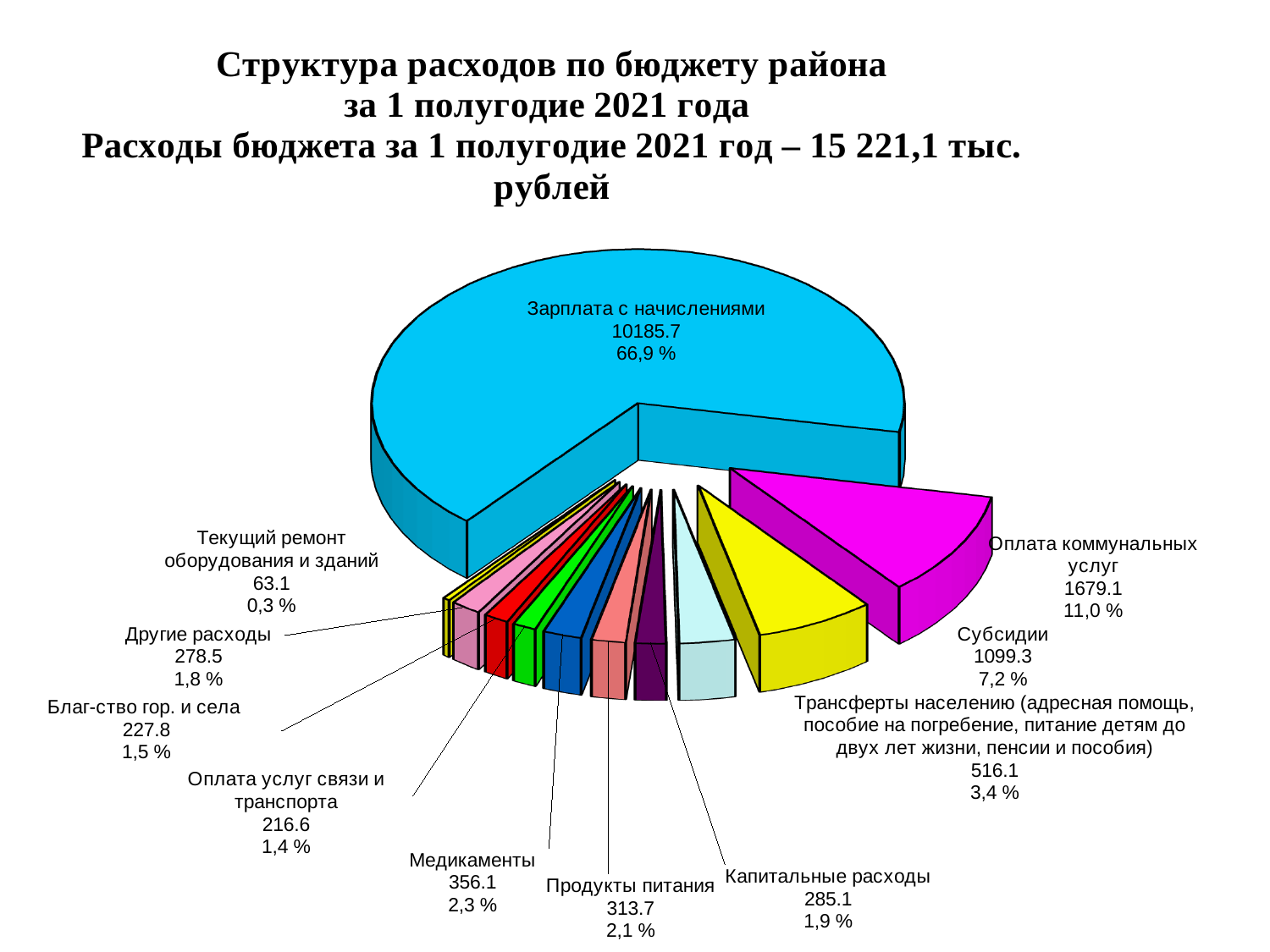
Which category has the smallest slice of the pie? Текущий ремонт оборудования и зданий What is the difference between the values for Оплата коммунальных услуг and Субсидии? 579.8 What is the value for Субсидии? 1099.3 Which category has the largest slice of the pie? Зарплата с начислениями What share of the pie does Оплата коммунальных услуг represent? 11,0 % What share of the pie does Текущий ремонт оборудования и зданий represent? 0,3 % Which is larger, the value for Медикаменты or the value for Продукты питания? Медикаменты How many categories (slices) does the pie chart have? 11 According to the slide title, what is the total budget expenditure for the first half of 2021? 15 221,1 тыс. рублей What type of chart is shown on the slide? pie chart What is the value for Капитальные расходы? 285.1 What is the value for Зарплата с начислениями? 10185.7